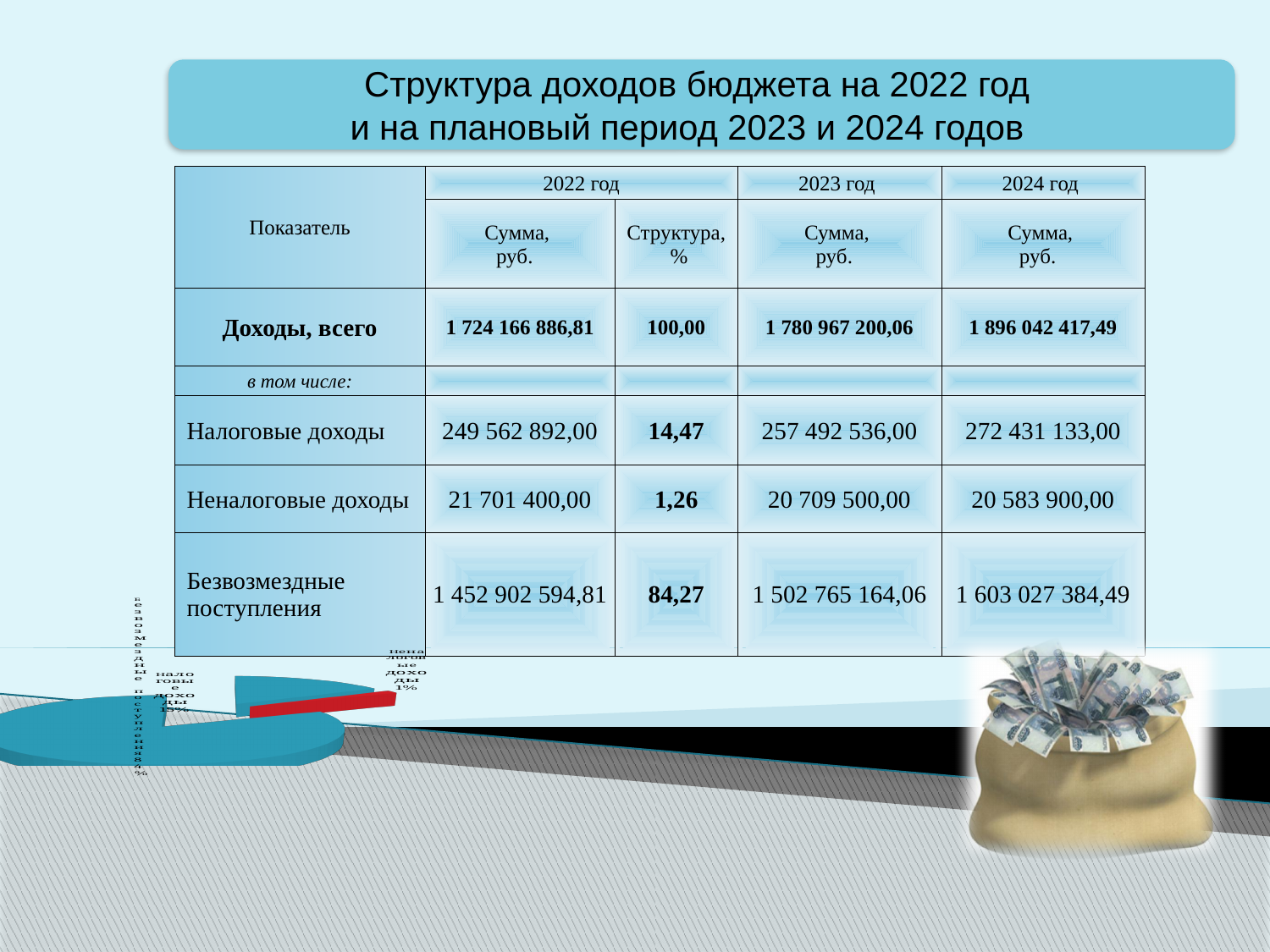
In the pie chart at the bottom left, which slice is the largest? Безвозмездные поступления What kind of chart is shown at the bottom left of the slide? Pie chart In the pie chart at the bottom left, what colour is the slice for налоговые доходы? Blue In the pie chart at the bottom left, which is larger: the share for налоговые доходы or the share for неналоговые доходы? Налоговые доходы In the pie chart at the bottom left, which slice is the smallest? Неналоговые доходы How many slices does the pie chart at the bottom left of the slide have? 3 In the pie chart at the bottom left, what share is shown for неналоговые доходы? 1% In the pie chart at the bottom left, what colour is the largest slice? Blue